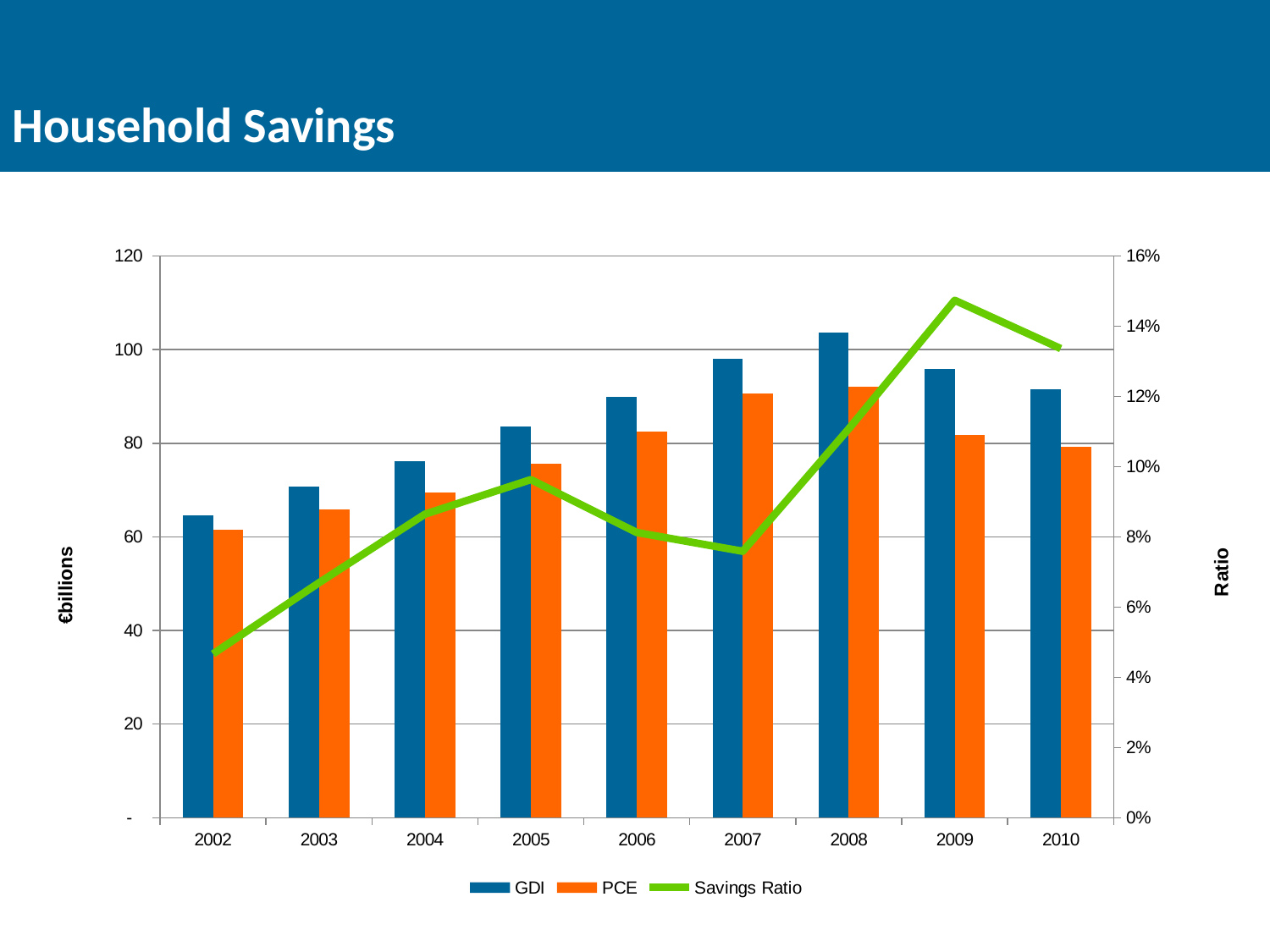
Which is larger in 2008, GDI or PCE? GDI Does the Savings Ratio rise or fall from 2007 to 2009? rise In which year is the Savings Ratio highest? 2009 In which year is GDI highest? 2008 What kind of chart is shown on the slide? A combined bar and line chart Is the GDI value for 2008 greater or less than 100? greater How many years are shown on the x axis? 9 Is the Savings Ratio for 2009 greater or less than 14%? greater In which year is the Savings Ratio lowest? 2002 Is the PCE value for 2007 greater or less than 80? greater How many series does the legend list? 3 In which year is GDI lowest? 2002